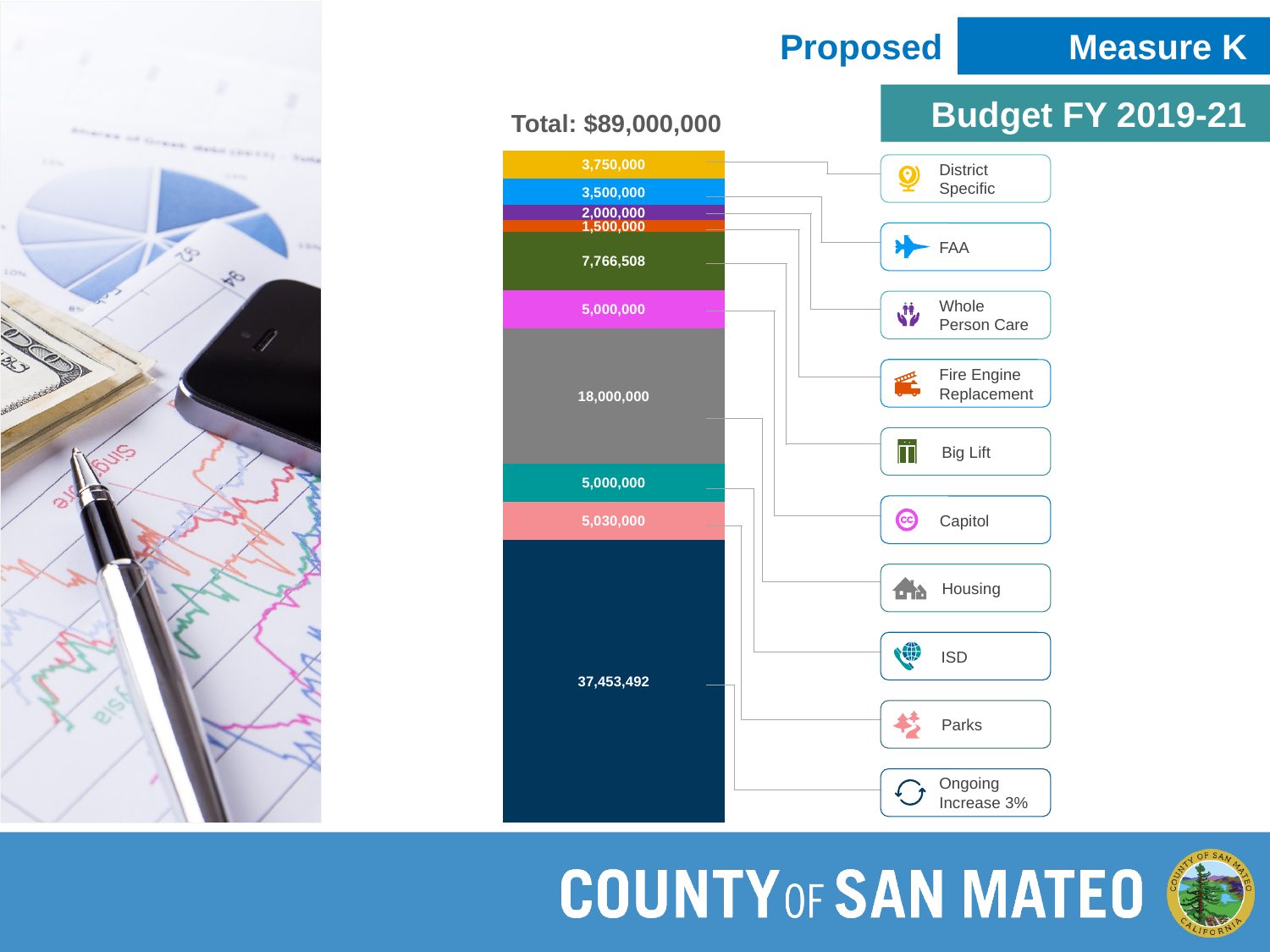
What total is printed above the chart? $89,000,000 Which is larger, the Housing segment or the Big Lift segment? Housing What kind of chart is shown on the slide? Stacked bar chart What is the value of the District Specific segment? 3,750,000 Which category has the largest segment in the bar? Ongoing Increase 3% What is the difference between the Housing segment and the Big Lift segment? 10,233,492 What is the value of the Housing segment? 18,000,000 How many segments make up the stacked bar? 10 What is the value of the Big Lift segment? 7,766,508 Which category has the smallest segment in the bar? Fire Engine Replacement What fiscal year period does the chart's title refer to? FY 2019-21 What is the value of the Ongoing Increase 3% segment? 37,453,492